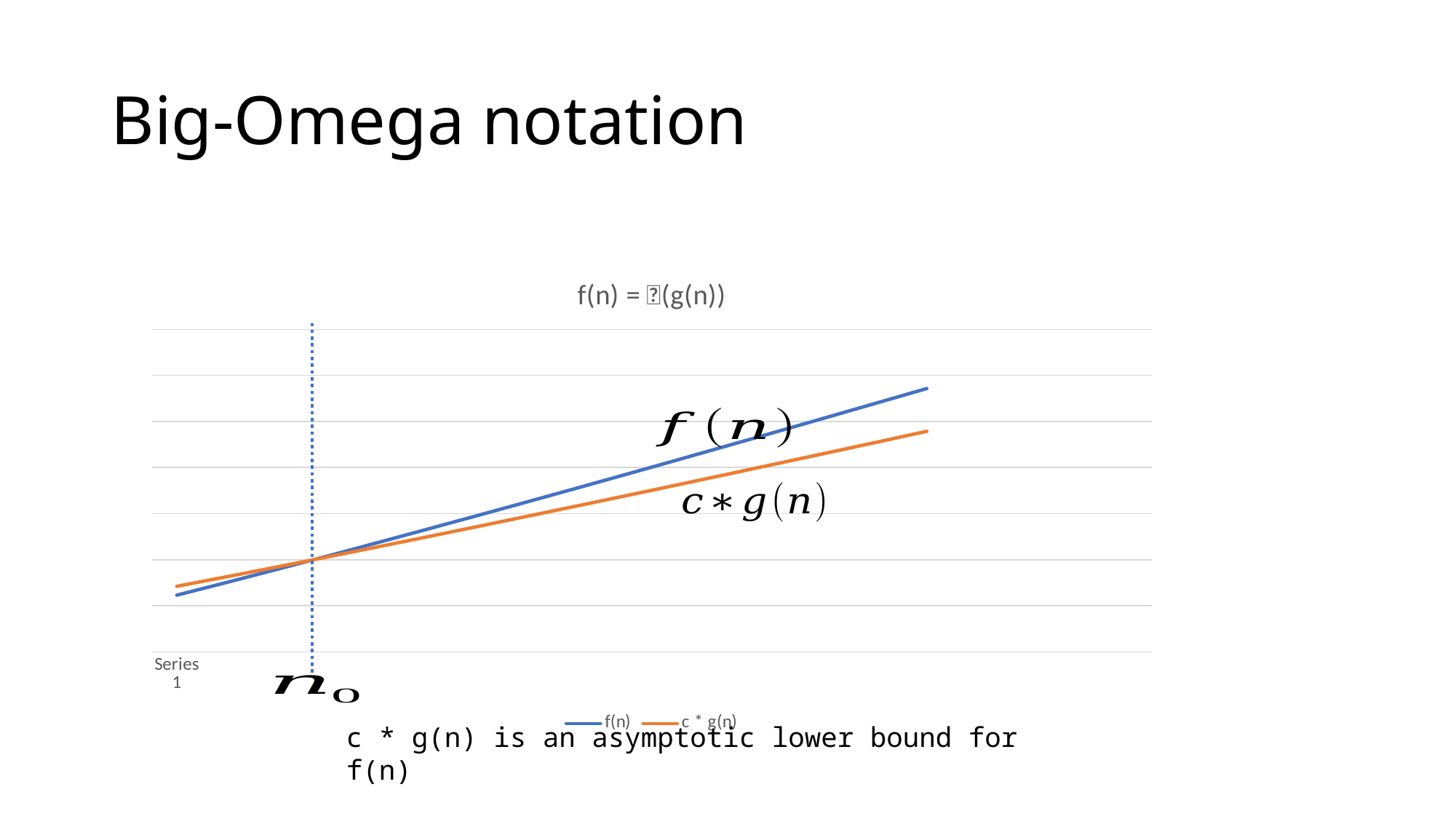
What kind of chart is shown on the slide? line chart At the right end of the chart, which line is higher, f(n) or c * g(n)? f(n) How many series does the chart's legend list? 2 Does the f(n) line rise or fall from left to right? rise Does the c * g(n) line rise or fall from left to right? rise Which series has the steeper slope, f(n) or c * g(n)? f(n) At the left end of the chart, which line is higher, f(n) or c * g(n)? c * g(n) What colour is the line for c * g(n)? orange Which series does the legend list first? f(n)